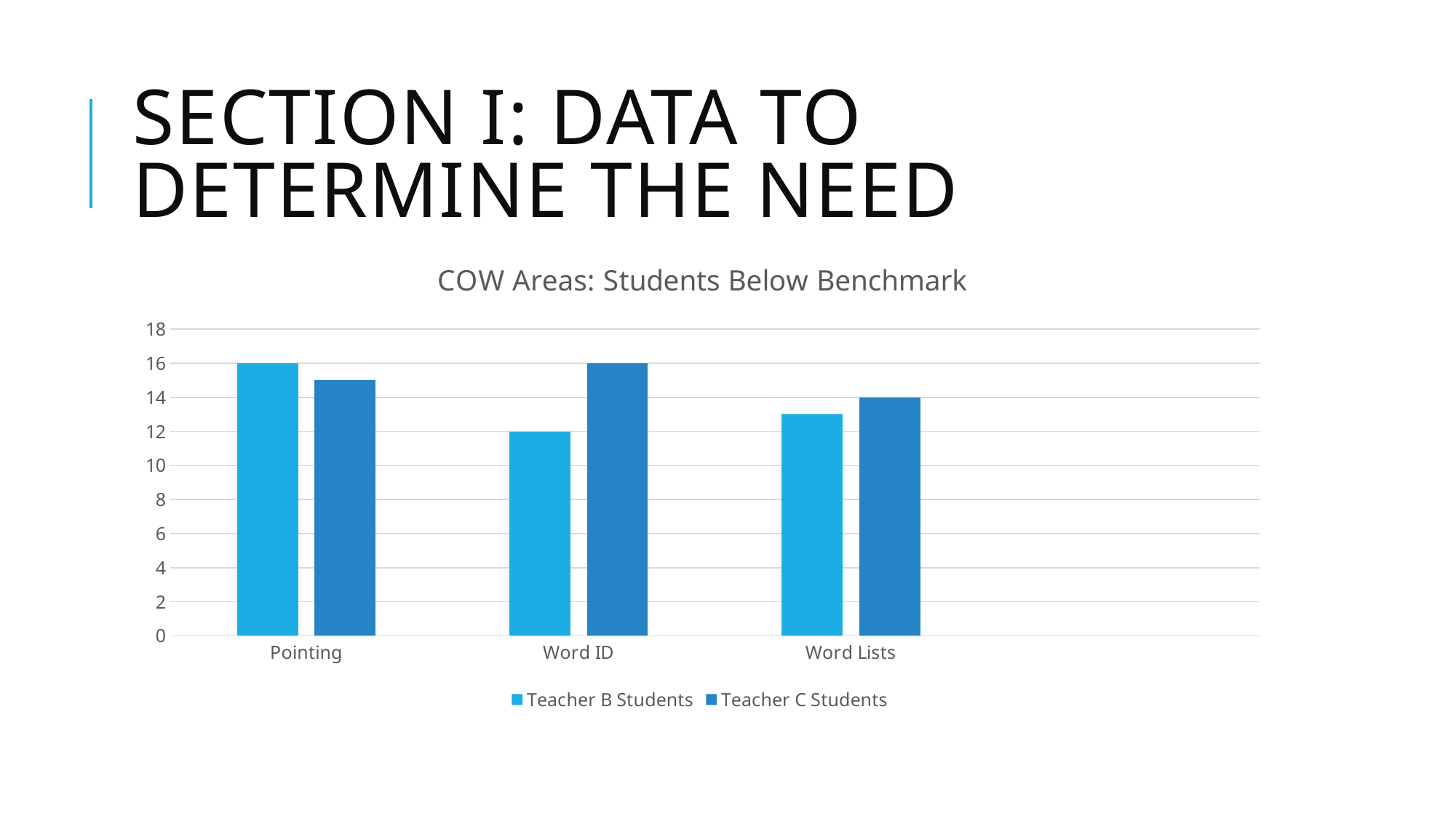
What is the title of the chart? COW Areas: Students Below Benchmark How many categories are shown on the x axis? 3 How many series does the legend list? 2 What is the value for Teacher C Students in the Word ID category? 16 What is the difference between Teacher C Students and Teacher B Students in the Word ID category? 4 Is the value for Teacher C Students in the Pointing category greater or less than 14? greater What is the value for Teacher C Students in the Word Lists category? 14 What is the value for Teacher B Students in the Word ID category? 12 What type of chart is shown on the slide? Bar chart In which category is the value for Teacher B Students the lowest? Word ID Is the value for Teacher B Students in the Word Lists category greater or less than 14? less What is the value for Teacher B Students in the Pointing category? 16